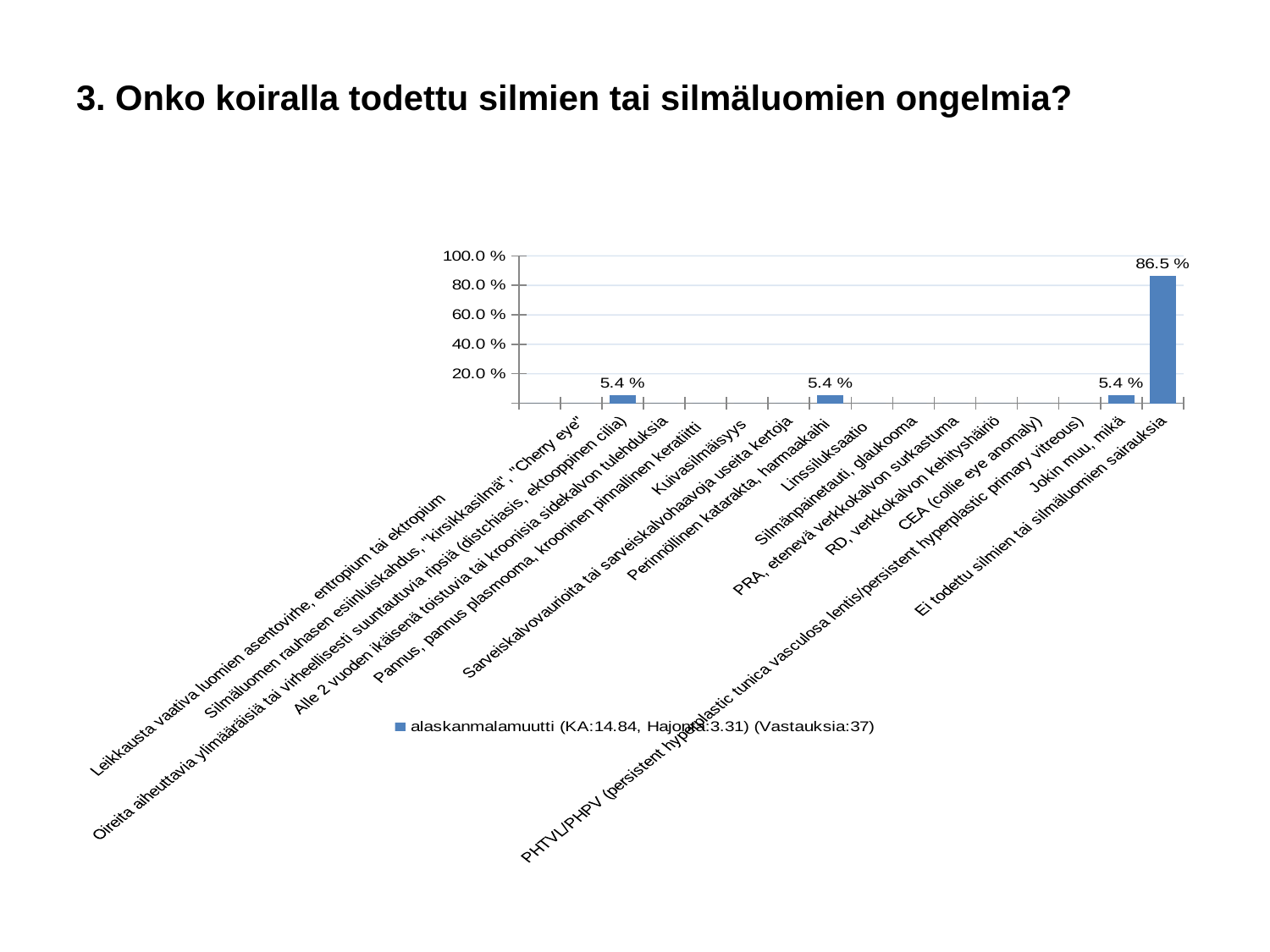
What is the difference between the value for "Ei todettu silmien tai silmäluomien sairauksia" and the value for "Jokin muu, mikä"? 81.1 % Which category has the highest value? Ei todettu silmien tai silmäluomien sairauksia How many series does the legend list? 1 What is the value for "Silmäluomen rauhasen esiinluiskahdus, "kirsikkasilmä", "Cherry eye""? 0.0 % How many categories are shown on the x axis? 16 What is the value for "Ei todettu silmien tai silmäluomien sairauksia"? 86.5 % Which is larger, the value for "Ei todettu silmien tai silmäluomien sairauksia" or the value for "Perinnöllinen katarakta, harmaakaihi"? Ei todettu silmien tai silmäluomien sairauksia Is the value for "Ei todettu silmien tai silmäluomien sairauksia" greater or less than 80.0 %? greater What is the value for "Jokin muu, mikä"? 5.4 % What kind of chart is shown on the slide? bar chart What is the value for "Perinnöllinen katarakta, harmaakaihi"? 5.4 % What is the legend entry of the chart? alaskanmalamuutti (KA:14.84, Hajonta:3.31) (Vastauksia:37)